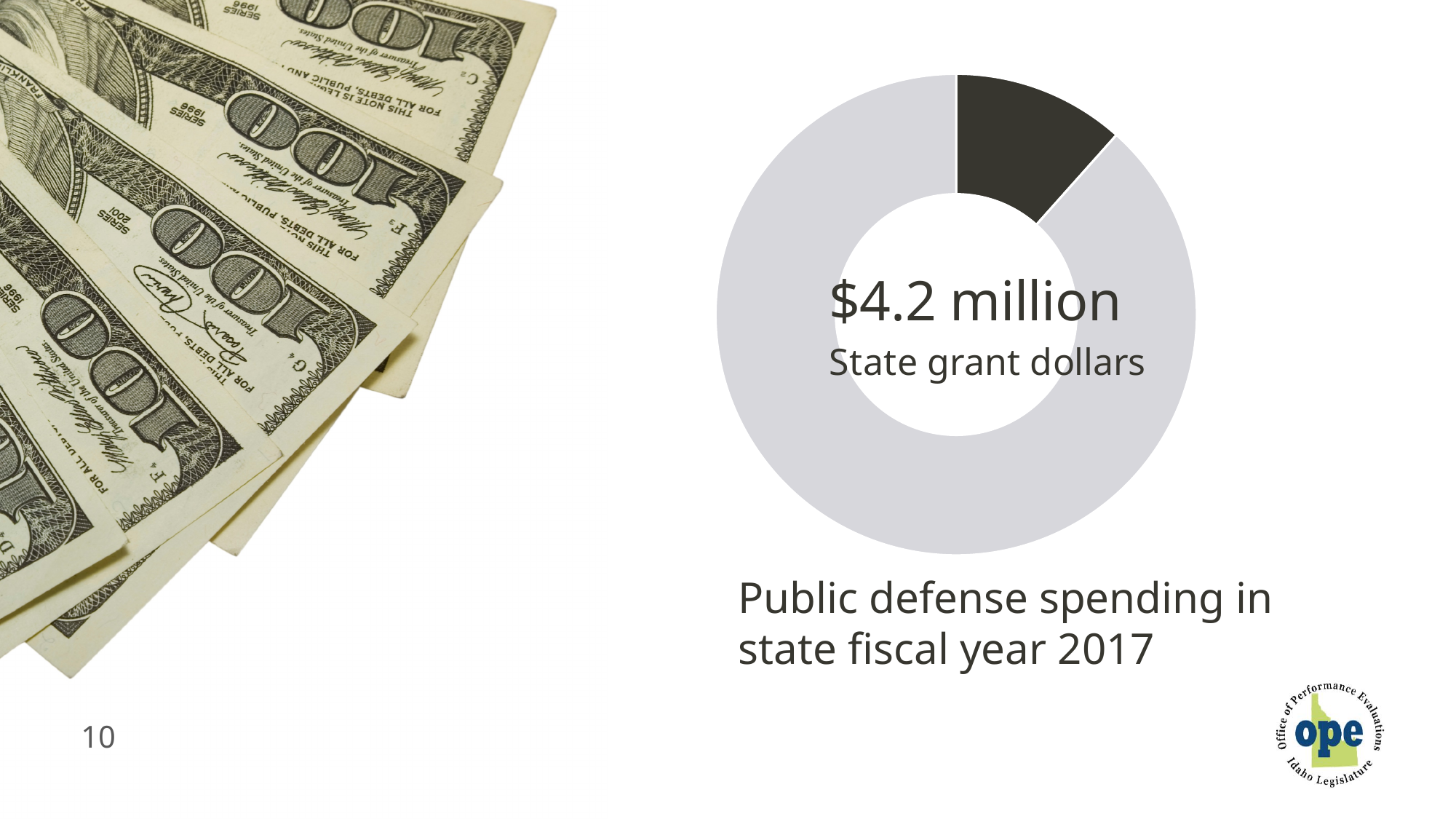
What is the title of the chart on the slide? Public defense spending in state fiscal year 2017 Does the dark slice represent more or less than half of the donut chart? less What does the $4.2 million in the center of the chart represent? State grant dollars What value is printed in the center of the donut chart? $4.2 million How many slices does the donut chart contain? 2 Which slice of the donut chart is the smallest? The dark slice Which fiscal year does the chart's title refer to? State fiscal year 2017 What kind of chart is shown on the slide? Pie chart (donut) Which slice of the donut chart is larger, the dark slice or the light gray slice? The light gray slice